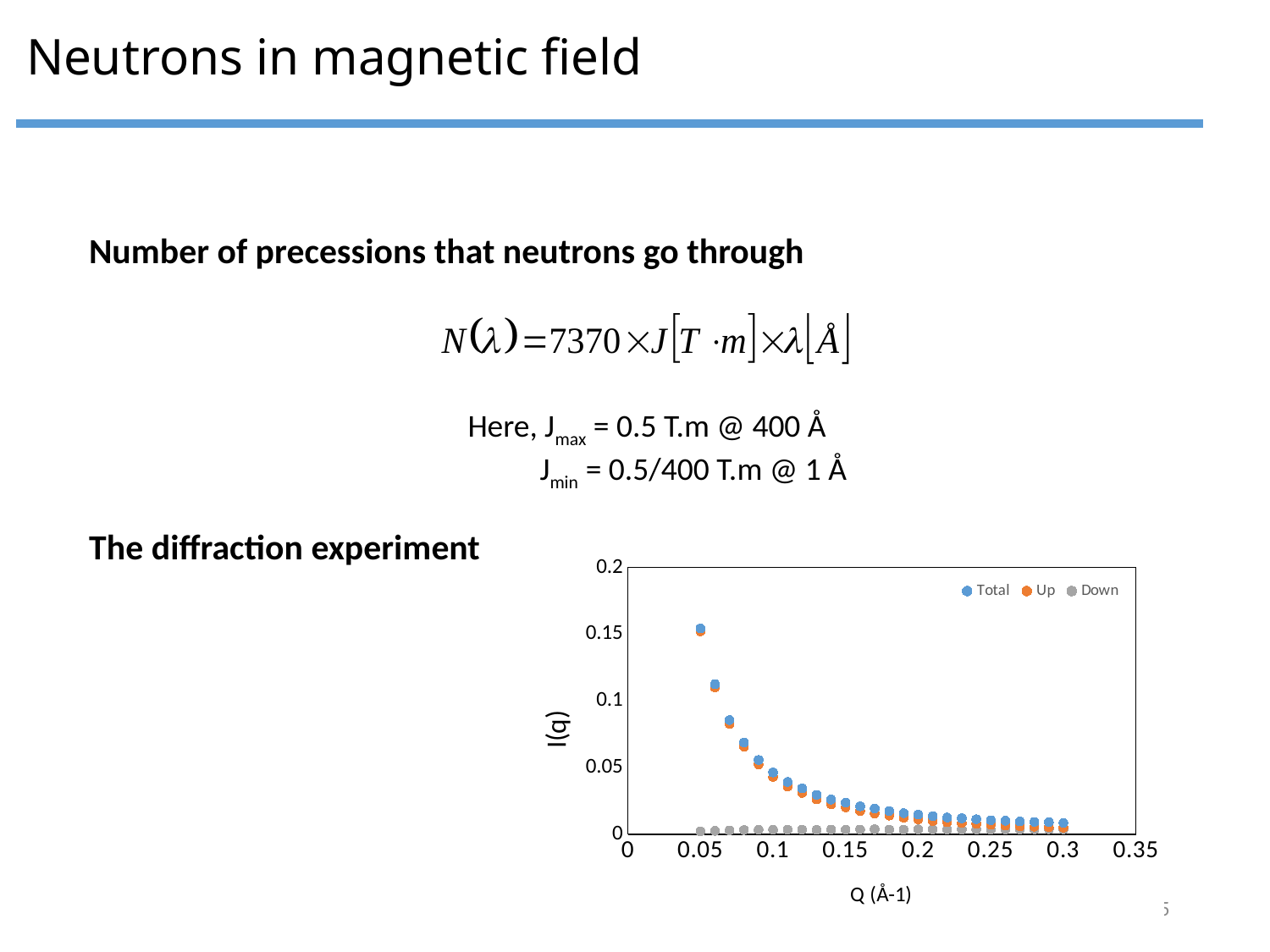
Which series has the lowest values across the whole Q range? Down At Q = 0.1, which series has the larger value, Total or Down? Total Is the Down value at Q = 0.05 greater or less than 0.05? less Is the Total value at Q = 0.05 greater or less than 0.1? greater Do the Total values rise or fall as Q increases along the x axis? Fall What kind of chart is shown on the slide? Scatter chart Is the Total value at Q = 0.2 greater or less than 0.05? less How many series does the chart legend list? 3 At Q = 0.05, which series has the larger value, Up or Down? Up What are the series names listed in the chart legend? Total, Up, Down What is the title of the chart's x axis? Q (Å-1)